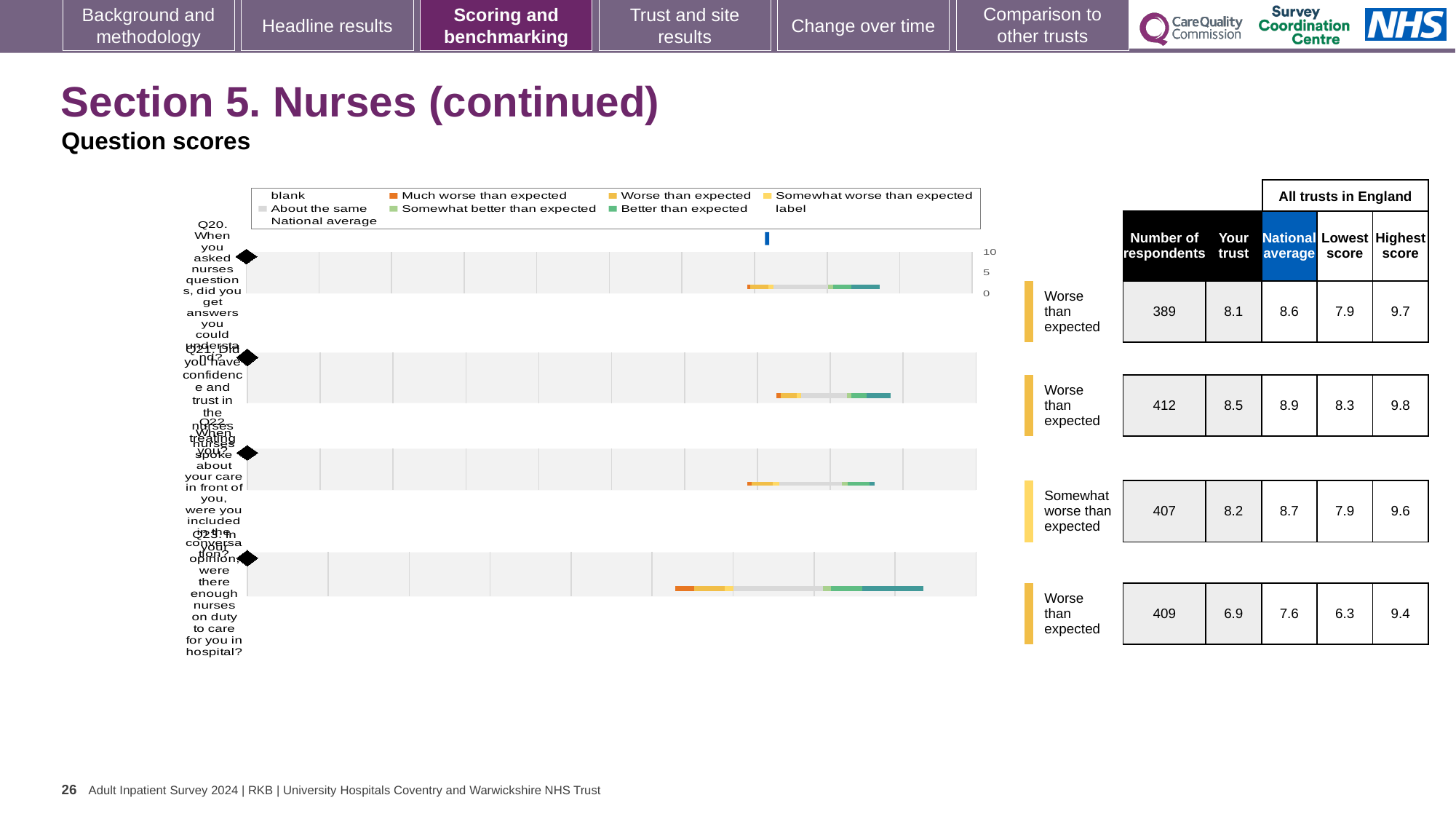
What is the national average score for Q23 (were there enough nurses on duty)? 7.6 What kind of chart is used to show the question scores on this slide? Bar chart Which question has the lowest 'Your trust' score? Q23 What benchmark category is shown for Q22? Somewhat worse than expected For Q21, how much higher is the national average than the 'Your trust' score? 0.4 Which question has the highest 'Your trust' score? Q21 What is the highest score among all trusts in England for Q21? 9.8 How many questions (rows) are plotted in the chart? 4 For Q23, what is the difference between the highest score and the lowest score across all trusts in England? 3.1 How many respondents answered Q22 (were you included in the conversation)? 407 What is the 'Your trust' score for Q20 (did you get answers you could understand)? 8.1 For Q20, which is larger: the 'Your trust' score or the national average? National average